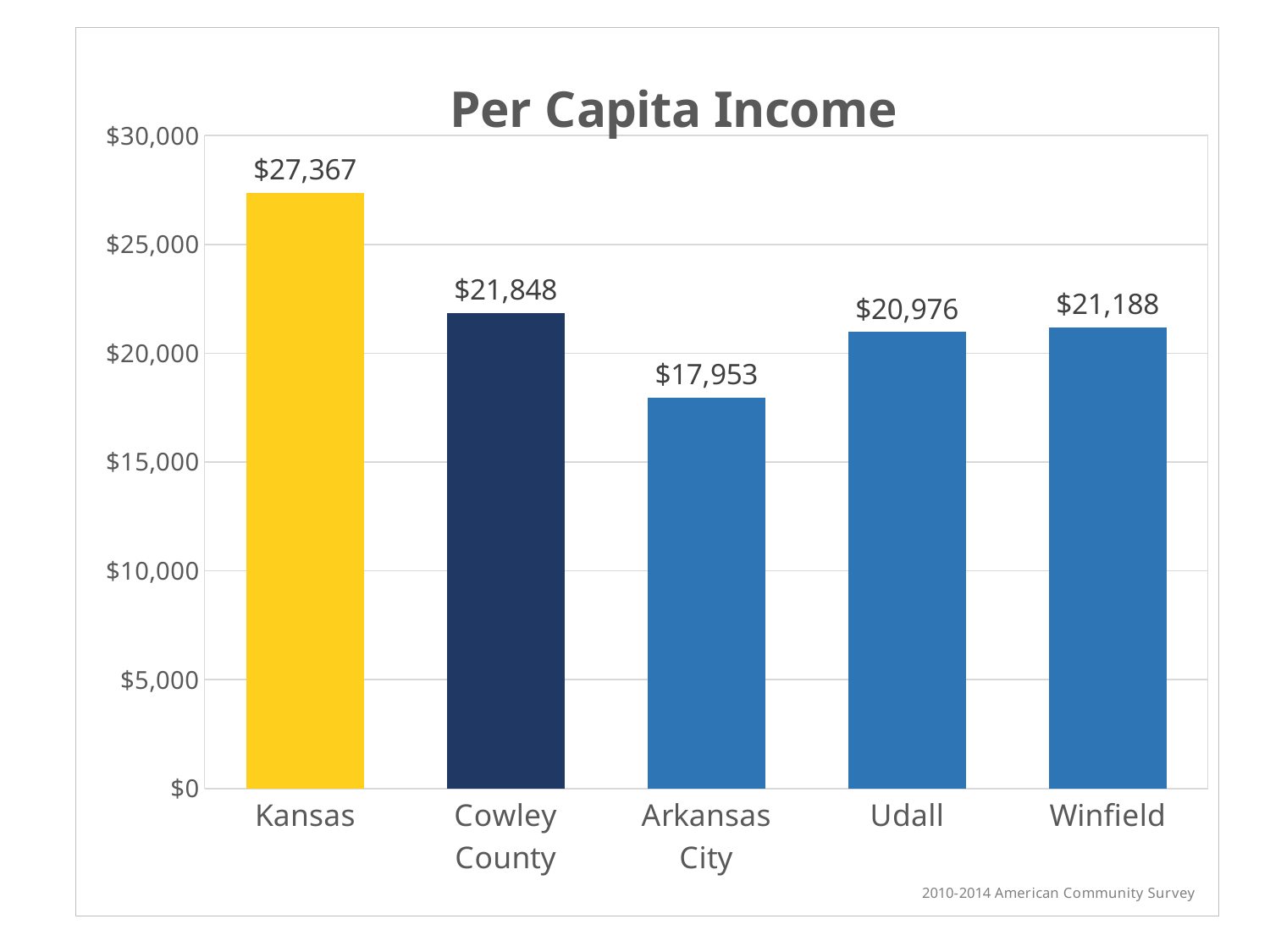
What is the title of the chart? Per Capita Income What is the per capita income for Cowley County? $21,848 What is the per capita income for Kansas? $27,367 What is the per capita income for Udall? $20,976 What kind of chart is shown on the slide? Bar chart Which category has the lowest per capita income? Arkansas City What is the difference in per capita income between Kansas and Cowley County? $5,519 What is the per capita income for Winfield? $21,188 What is the per capita income for Arkansas City? $17,953 How many categories are shown in the chart? 5 Which has a higher per capita income, Winfield or Udall? Winfield Which category has the highest per capita income? Kansas